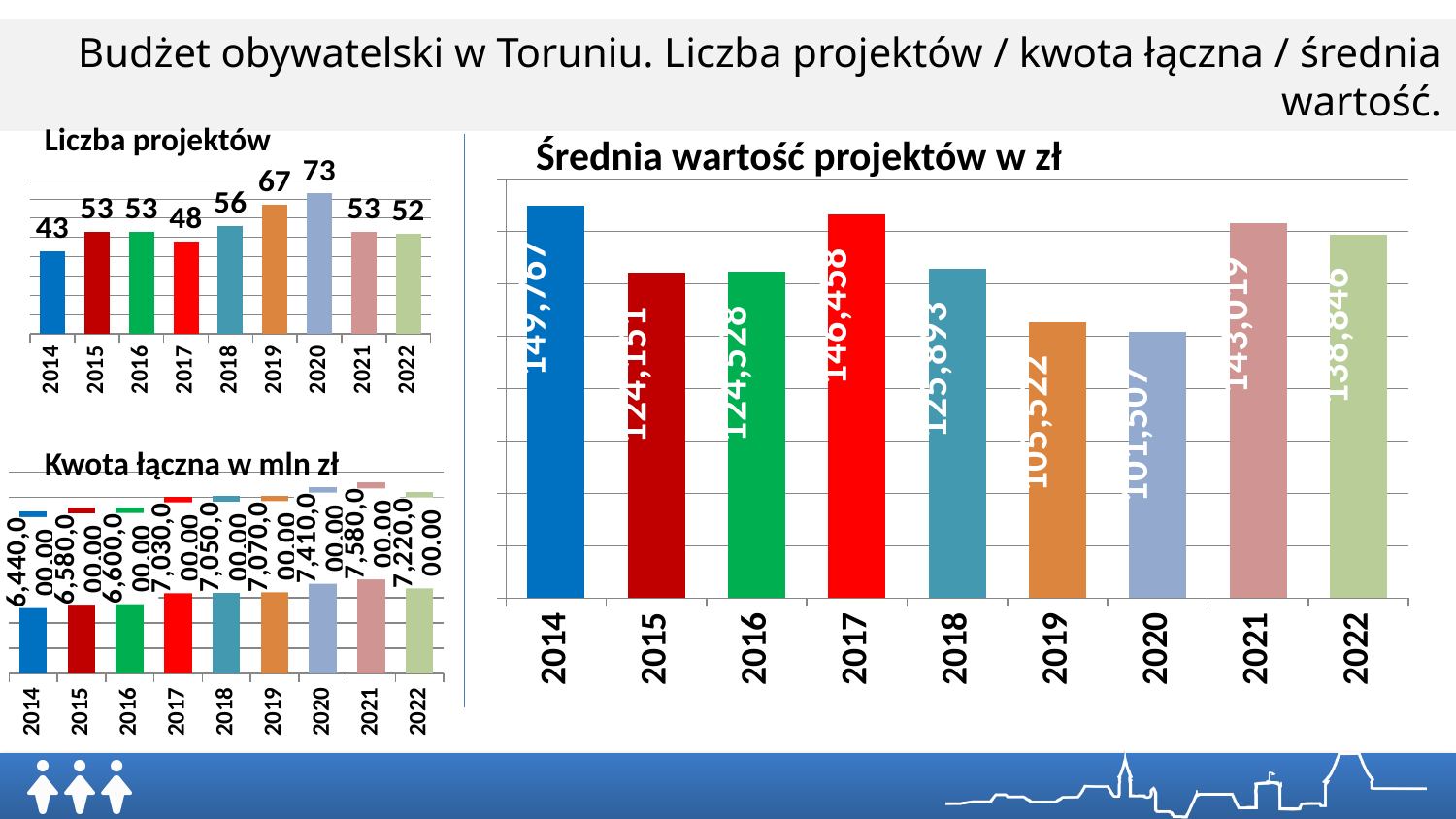
In the 'Liczba projektów' chart, which is larger, the value for 2017 or the value for 2018? 2018 In the 'Liczba projektów' chart, what is the value for 2019? 67 In the 'Liczba projektów' chart, what is the value for 2014? 43 In the 'Średnia wartość projektów w zł' chart, which year has the highest value? 2014 In the 'Średnia wartość projektów w zł' chart, which is larger, the value for 2017 or the value for 2021? 2017 In the 'Liczba projektów' chart, how many years are shown? 9 In the 'Średnia wartość projektów w zł' chart, which year has the lowest value? 2020 In the 'Liczba projektów' chart, which year has the highest value? 2020 In the 'Liczba projektów' chart, what is the value for 2020? 73 In the 'Liczba projektów' chart, which year has the lowest value? 2014 In the 'Liczba projektów' chart, what is the difference between the values for 2020 and 2014? 30 What kind of chart is the 'Kwota łączna w mln zł' chart? bar chart